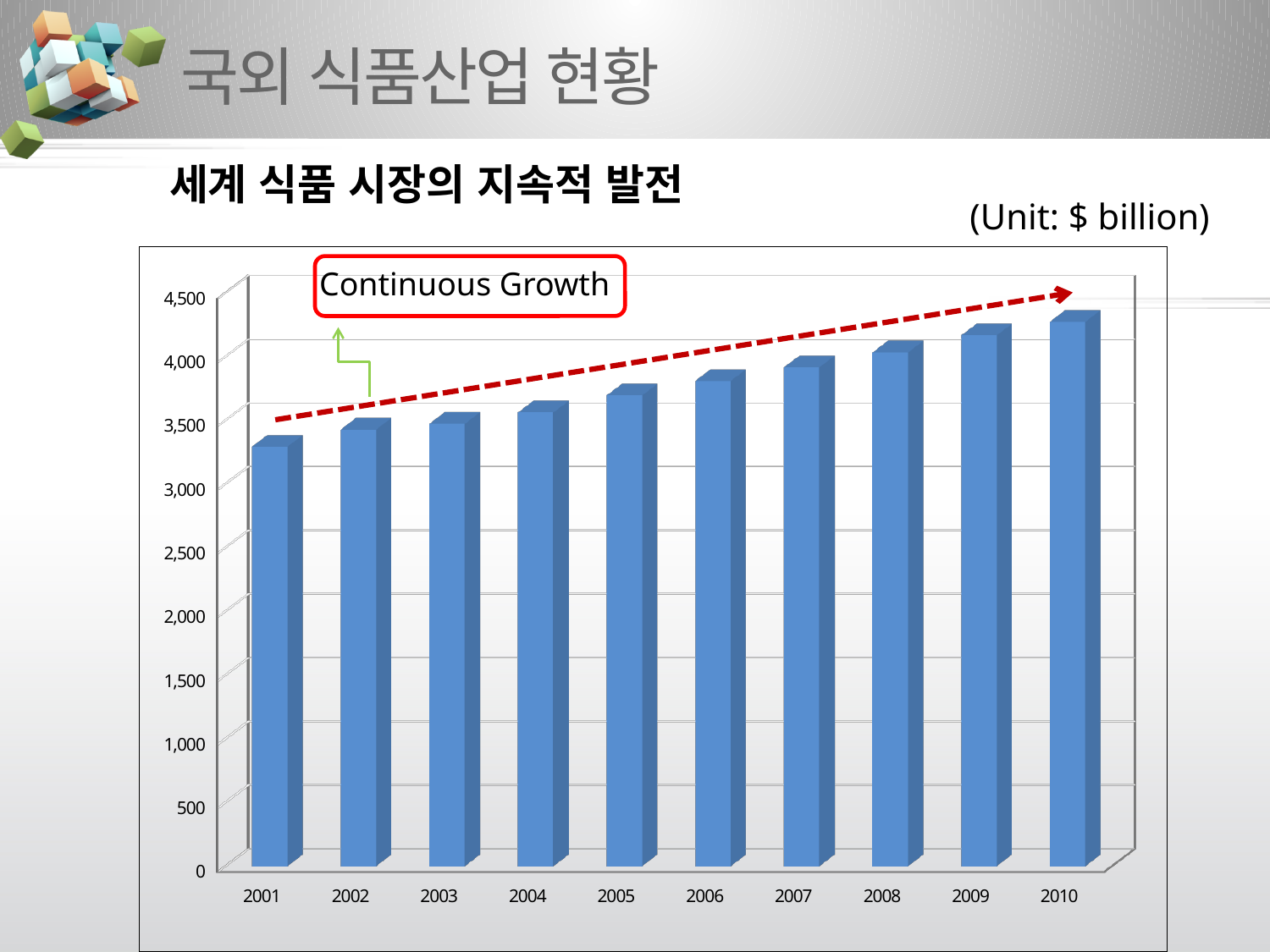
How many years are shown on the x axis of the chart? 10 Do the values rise or fall from 2001 to 2010? rise What text is written in the red box annotation on the chart? Continuous Growth Is the value for 2001 greater or less than 3,500? less Is the value for 2003 greater or less than 4,000? less Is the value for 2006 greater or less than 3,500? greater Which year has the lowest bar in the chart? 2001 Which is larger, the value for 2010 or the value for 2001? 2010 Which year has the highest bar in the chart? 2010 What unit is stated for the chart values? $ billion What kind of chart is shown on the slide? bar chart